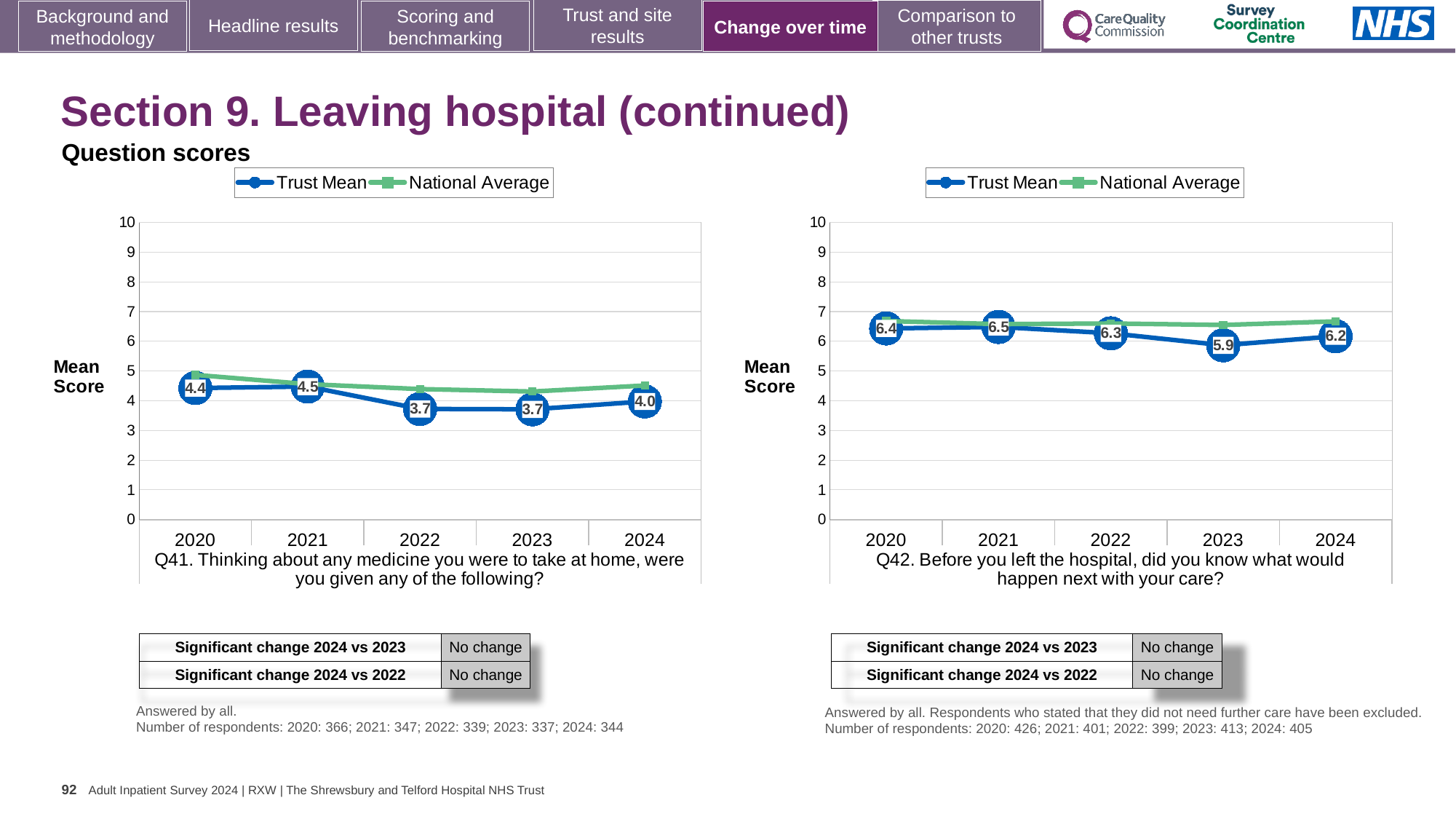
On the Q42 chart (right), which year has the lowest Trust Mean score? 2023 How many years are plotted on the Q42 chart (right)? 5 On the Q41 chart (left), is the Trust Mean score for 2020 or 2024 larger? 2020 On the Q42 chart (right), what is the difference between the Trust Mean scores for 2021 and 2023? 0.6 On the Q42 chart (right), what is the Trust Mean score for 2023? 5.9 On the Q41 chart (left), what is the Trust Mean score for 2022? 3.7 On the Q41 chart (left), is the National Average for 2020 greater or less than 4? greater On the Q41 chart (left), what is the Trust Mean score for 2024? 4.0 On the Q42 chart (right), which year has the highest Trust Mean score? 2021 How many series does the legend of the Q41 chart (left) list? 2 What kind of chart is the Q42 chart (right)? Line chart On the Q41 chart (left), what is the difference between the Trust Mean scores for 2021 and 2022? 0.8